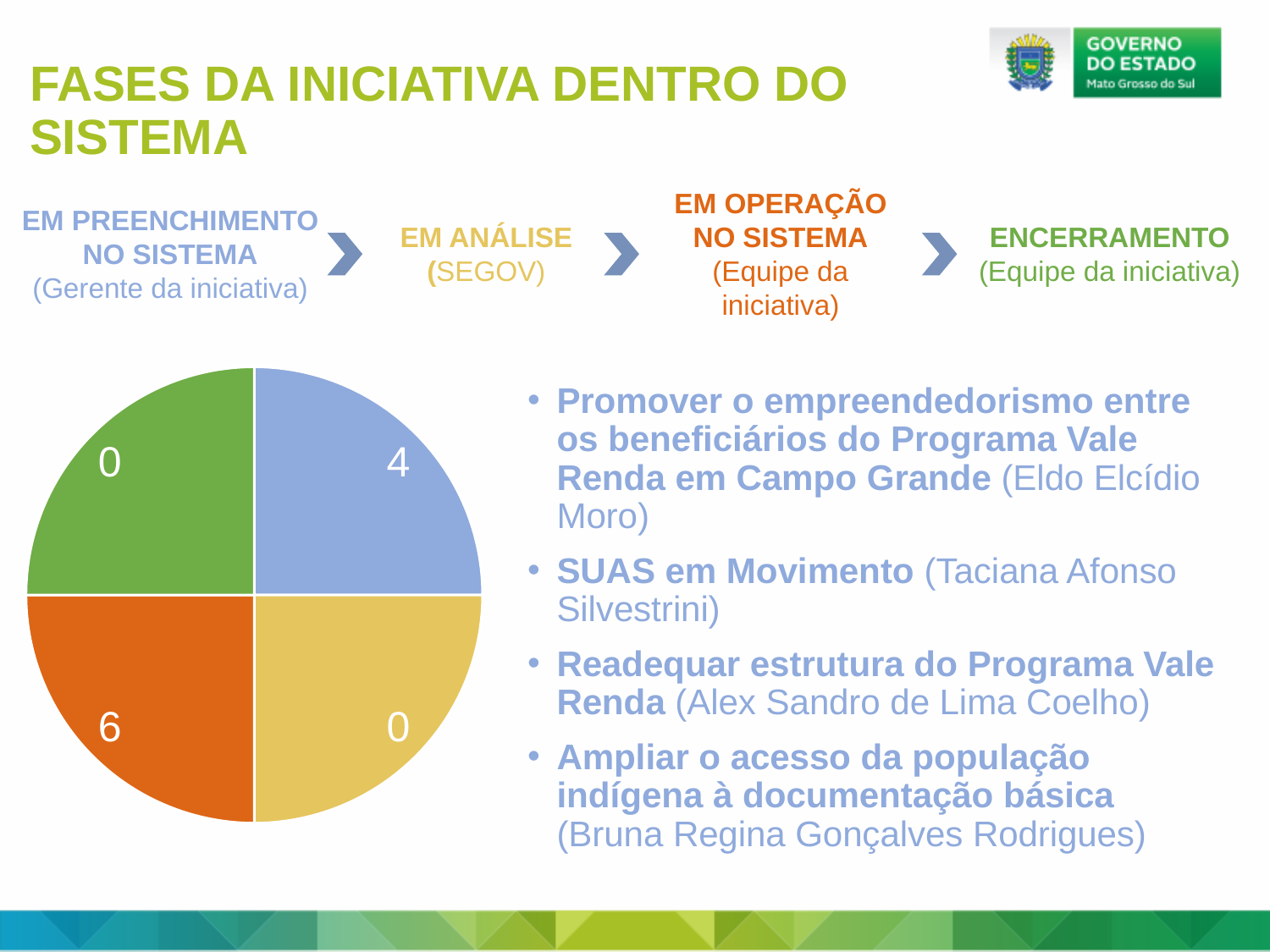
Which slices of the pie chart show a value of 0? green and yellow What kind of chart is shown on the left of the slide? pie chart Which slice of the pie chart has the highest value? orange (6) What value is shown on the blue slice of the pie chart? 4 What value is shown on the green slice of the pie chart? 0 How many slices does the pie chart have? 4 What colour is the slice labelled 4 in the pie chart? blue What value is shown on the orange slice of the pie chart? 6 Which has a larger value, the blue slice or the orange slice? orange What is the difference between the orange slice's value and the blue slice's value? 2 What value is shown on the yellow slice of the pie chart? 0 What is the sum of all the values labelled on the pie chart? 10